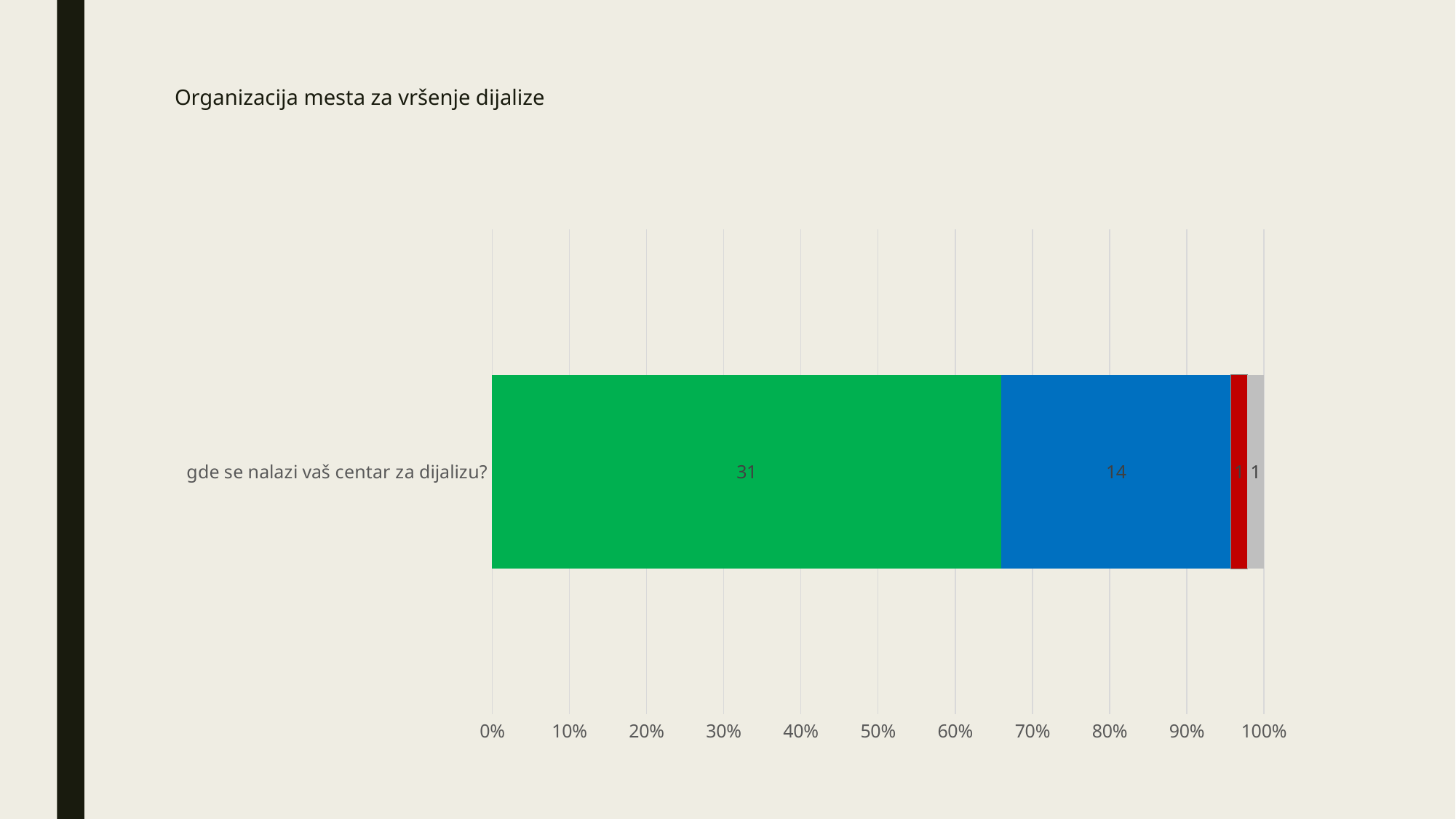
Does the green segment end at a point greater or less than 60% on the x axis? greater What is the title of the chart? Organizacija mesta za vršenje dijalize What value is printed on the blue segment of the bar? 14 What value is printed on the red segment of the bar? 1 Which segment of the bar has the largest value? the green segment (31) Which is larger, the green segment or the blue segment? the green segment What is the difference between the green segment value and the blue segment value? 17 What is the category label shown on the chart? gde se nalazi vaš centar za dijalizu? What kind of chart is shown on the slide? bar chart What is the total of all segments in the stacked bar? 47 What value is printed on the green segment of the bar? 31 How many categories are plotted on the vertical axis of the chart? 1